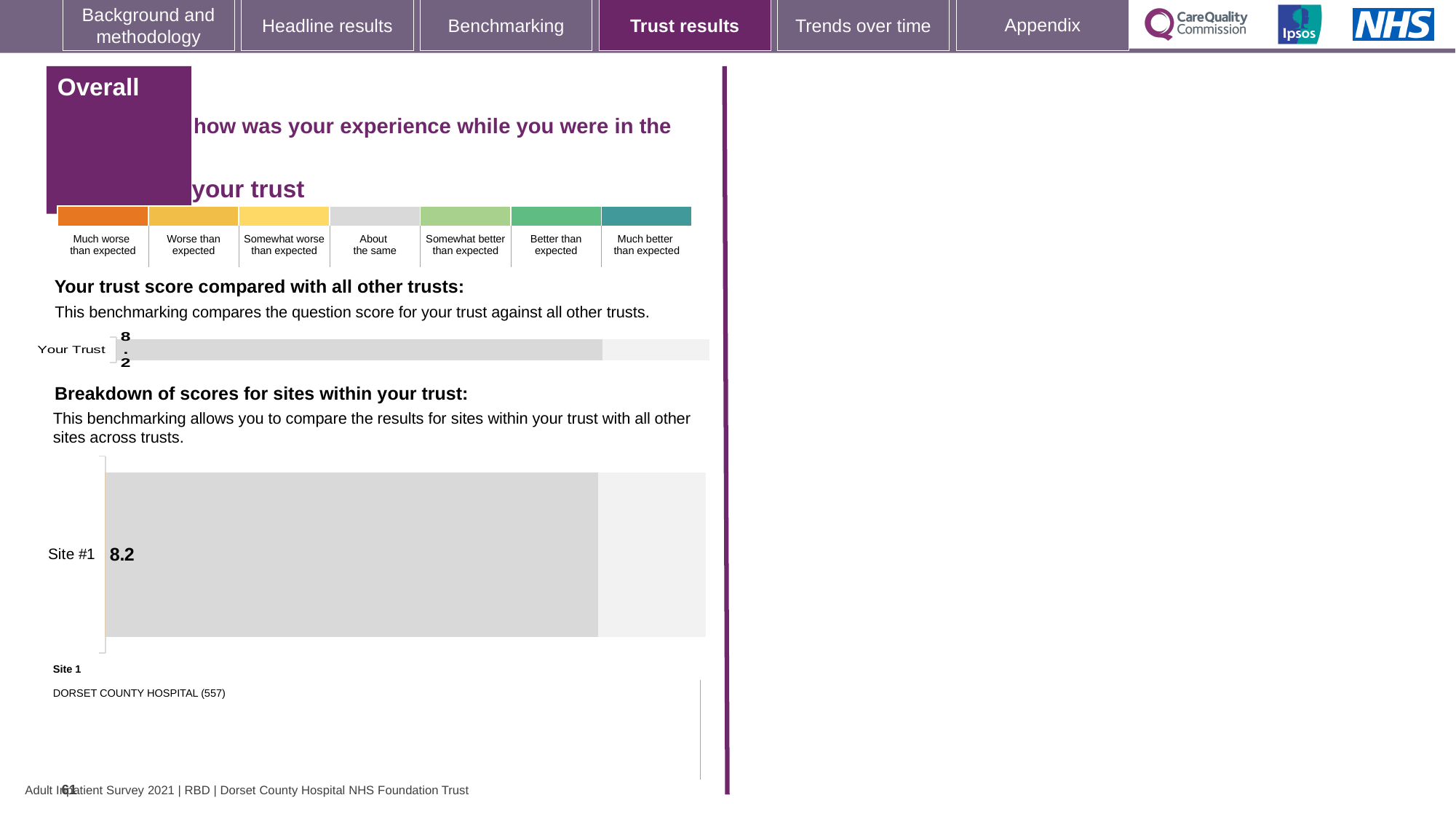
In the 'Breakdown of scores for sites within your trust' chart, what is the score for Site #1? 8.2 How many sites are plotted in the 'Breakdown of scores for sites within your trust' chart? 1 What is the difference between the Your Trust score and the Site #1 score on the slide? 0 What is the category label of the single bar in the 'Your trust score compared with all other trusts' chart? Your Trust Is the Site #1 score in the 'Breakdown of scores for sites within your trust' chart larger than, smaller than, or equal to the Your Trust score? equal Which hospital is listed as Site 1 below the 'Breakdown of scores for sites within your trust' chart? DORSET COUNTY HOSPITAL (557) What kind of chart is the 'Breakdown of scores for sites within your trust' chart? bar chart How many categories are plotted in the 'Your trust score compared with all other trusts' chart? 1 In the 'Your trust score compared with all other trusts' chart, what is the score for Your Trust? 8.2 What kind of chart is the 'Your trust score compared with all other trusts' chart? bar chart